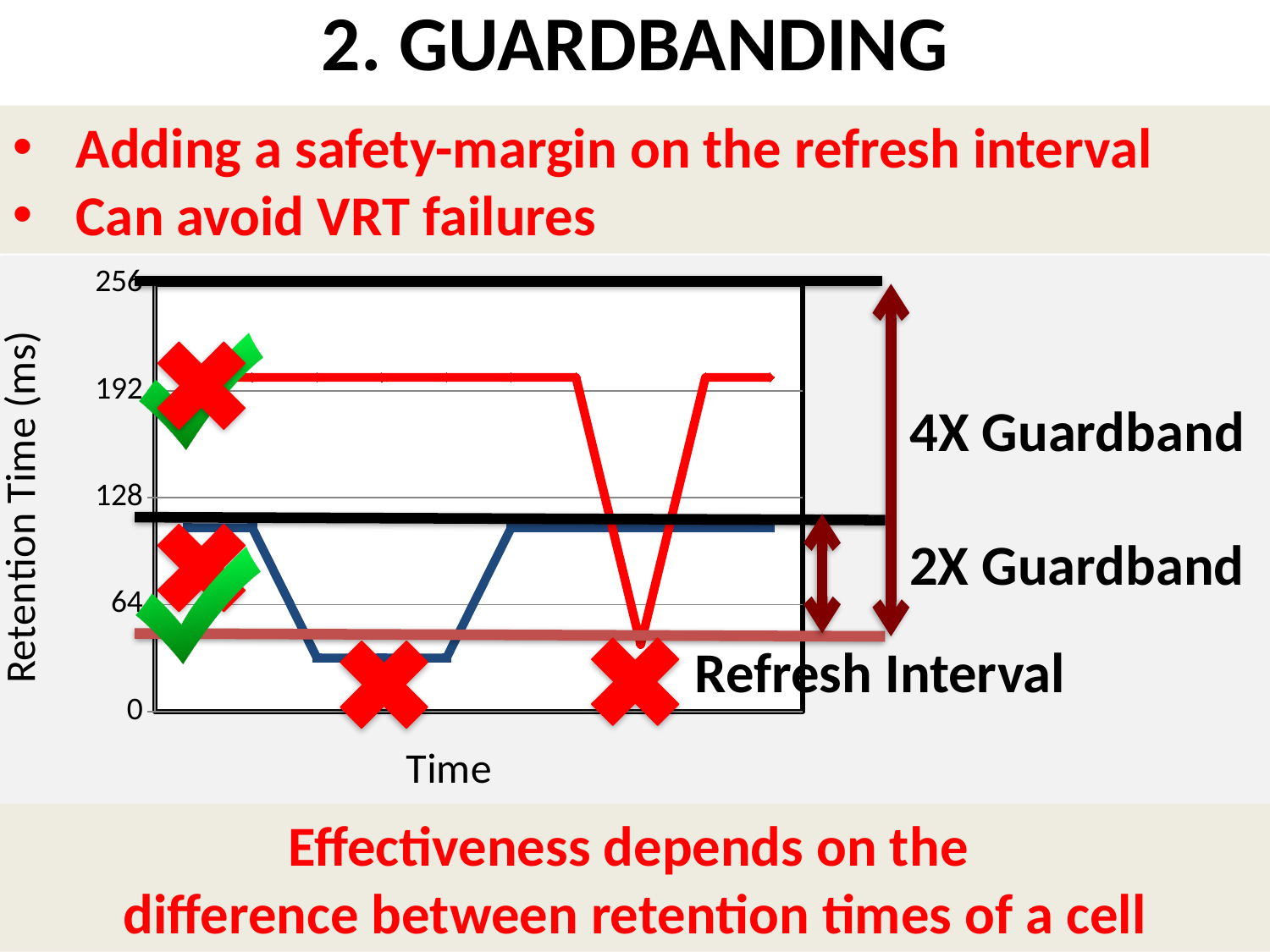
What kind of chart is shown on the slide? line chart What is the label of the horizontal axis of the chart? Time Which line reaches a higher retention time at its flat level, the red line or the blue line? the red line Is the flat level of the blue line greater or less than 64? greater What is the label of the vertical axis of the chart? Retention Time (ms) Is the flat level of the red line greater or less than 128? greater Is the lowest point of the blue line's dip greater or less than 64? less How many plotted lines (series) are drawn in the chart? 2 What is the highest tick value shown on the vertical axis? 256